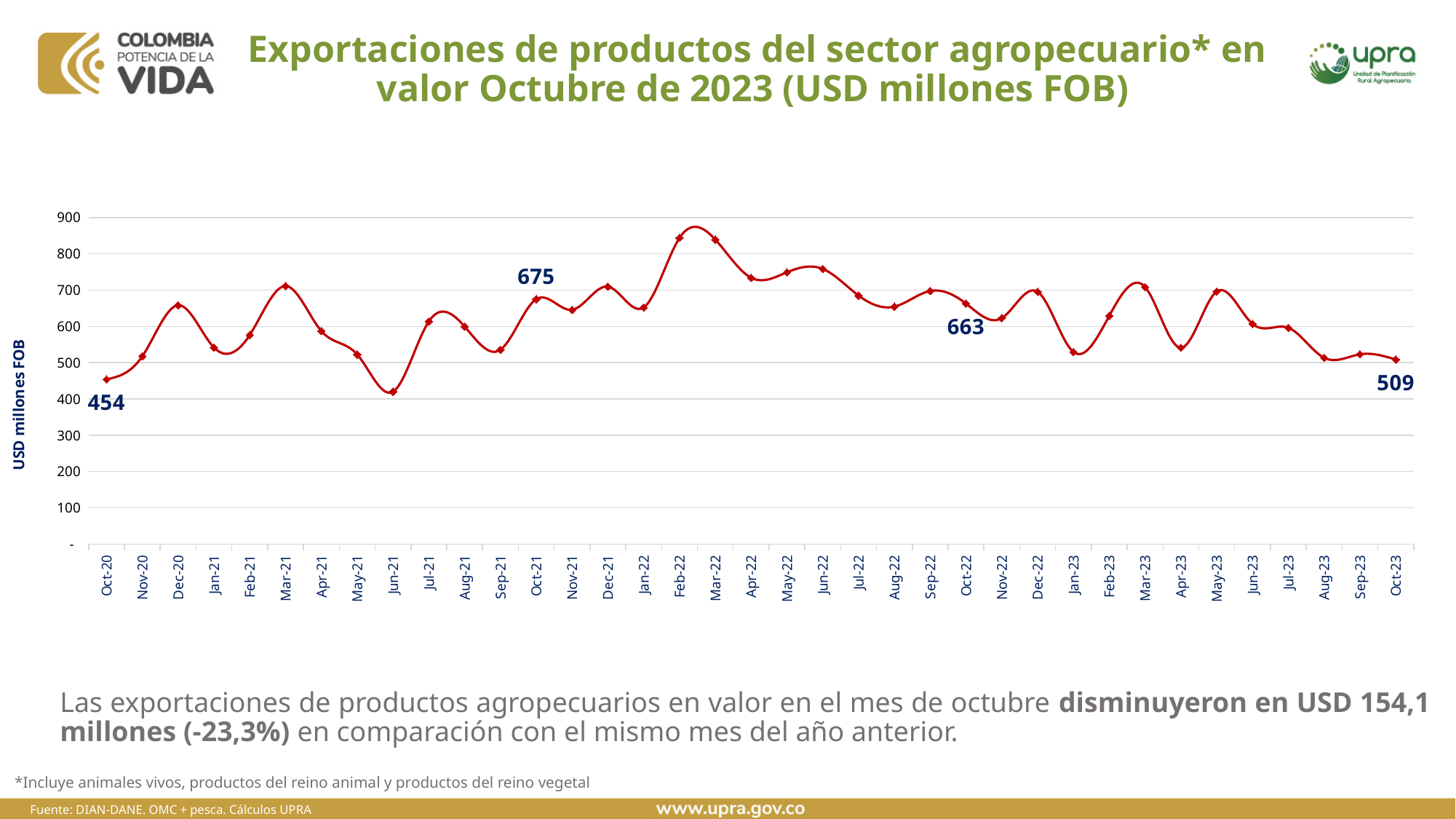
What is the value for Oct-20? 454 What is the value for Oct-23? 509 What kind of chart is shown on the slide? line chart What is the difference between the values for Oct-22 and Oct-23? 154 Which month has the highest value on the chart? Feb-22 Is the value for Jun-21 greater or less than 500? less What is the value for Oct-21? 675 Is the value for Feb-22 greater or less than 800? greater Which month has the lowest value on the chart? Jun-21 What is the value for Oct-22? 663 What is the difference between the values for Oct-21 and Oct-20? 221 Which is larger, the value for Oct-21 or the value for Oct-22? Oct-21